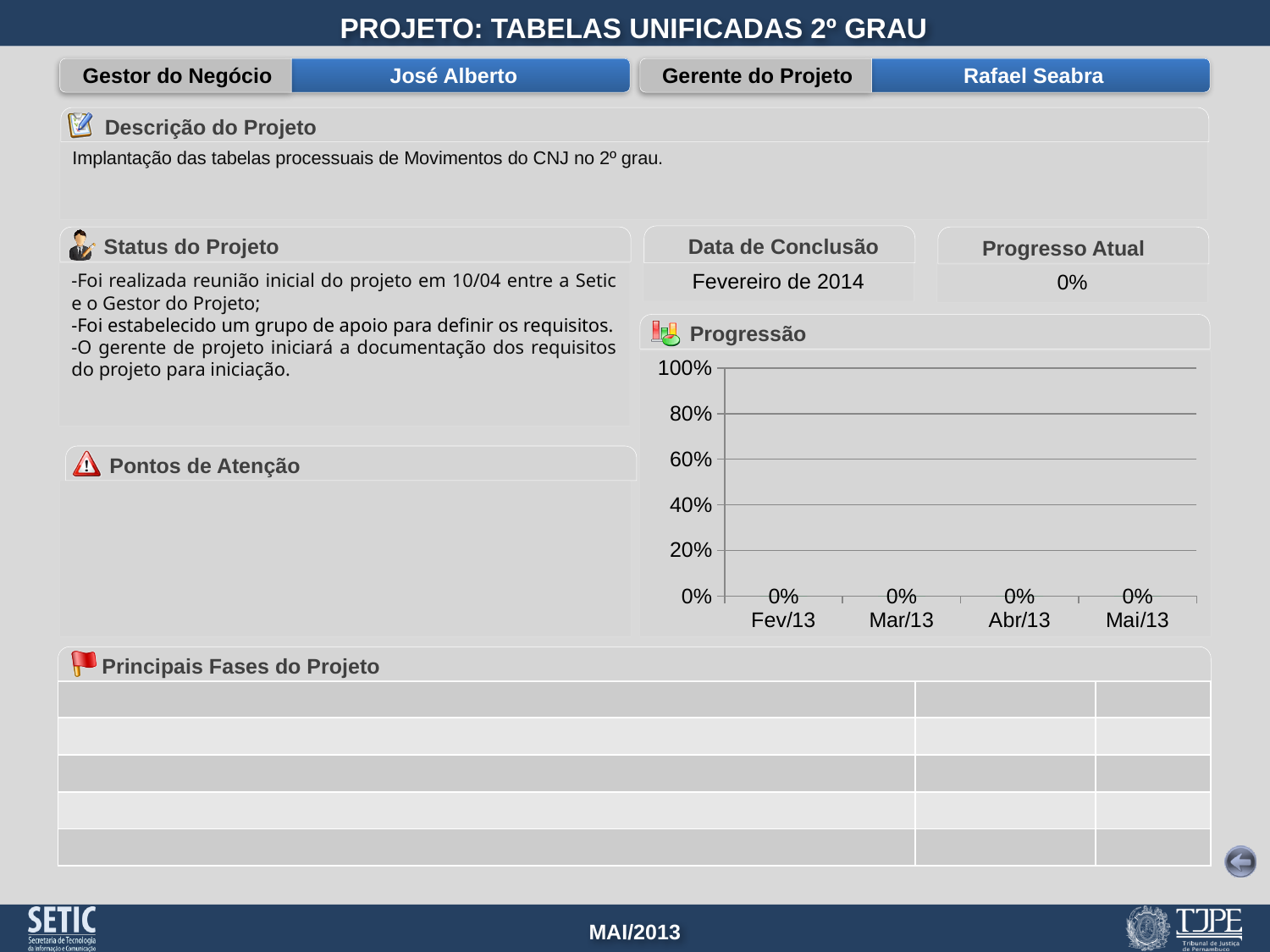
In the Progressão chart, what is the value for Mar/13? 0% In the Progressão chart, is the value for Mai/13 greater or less than 40%? less How many months are shown on the x axis of the Progressão chart? 4 In the Progressão chart, what is the difference between the values for Mai/13 and Fev/13? 0% In the Progressão chart, what is the value for Fev/13? 0% What is the highest tick label on the y axis of the Progressão chart? 100% What is the title of the chart on the slide? Progressão In the Progressão chart, what is the value for Abr/13? 0% In the Progressão chart, is the value for Abr/13 greater or less than 20%? less Do the values in the Progressão chart rise, fall, or stay flat from Fev/13 to Mai/13? stay flat In the Progressão chart, what is the value for Mai/13? 0%